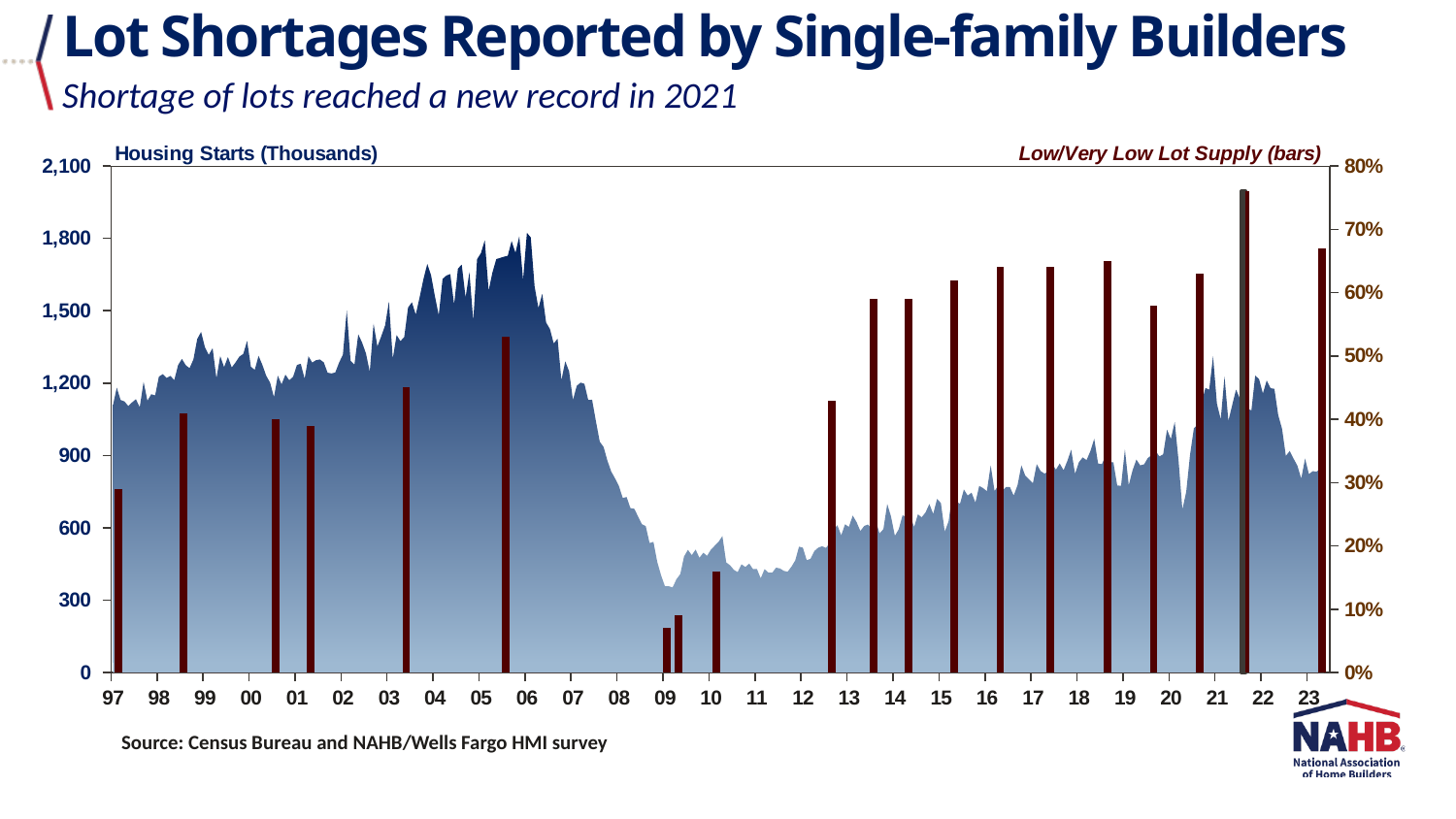
Which year has the shortest Low/Very Low Lot Supply bar? 09 Is the Low/Very Low Lot Supply bar for 10 greater or less than 20%? less Which year has the tallest Low/Very Low Lot Supply bar? 21 Is the Low/Very Low Lot Supply bar for 97 greater or less than 40%? less Is the Low/Very Low Lot Supply bar for 21 greater or less than 70%? greater What is the label of the left vertical axis? Housing Starts (Thousands) Do housing starts rise or fall between 06 and 09? fall Which is larger, the Low/Very Low Lot Supply bar for 21 or for 23? 21 What kind of chart is shown on the slide? Combined area and bar chart